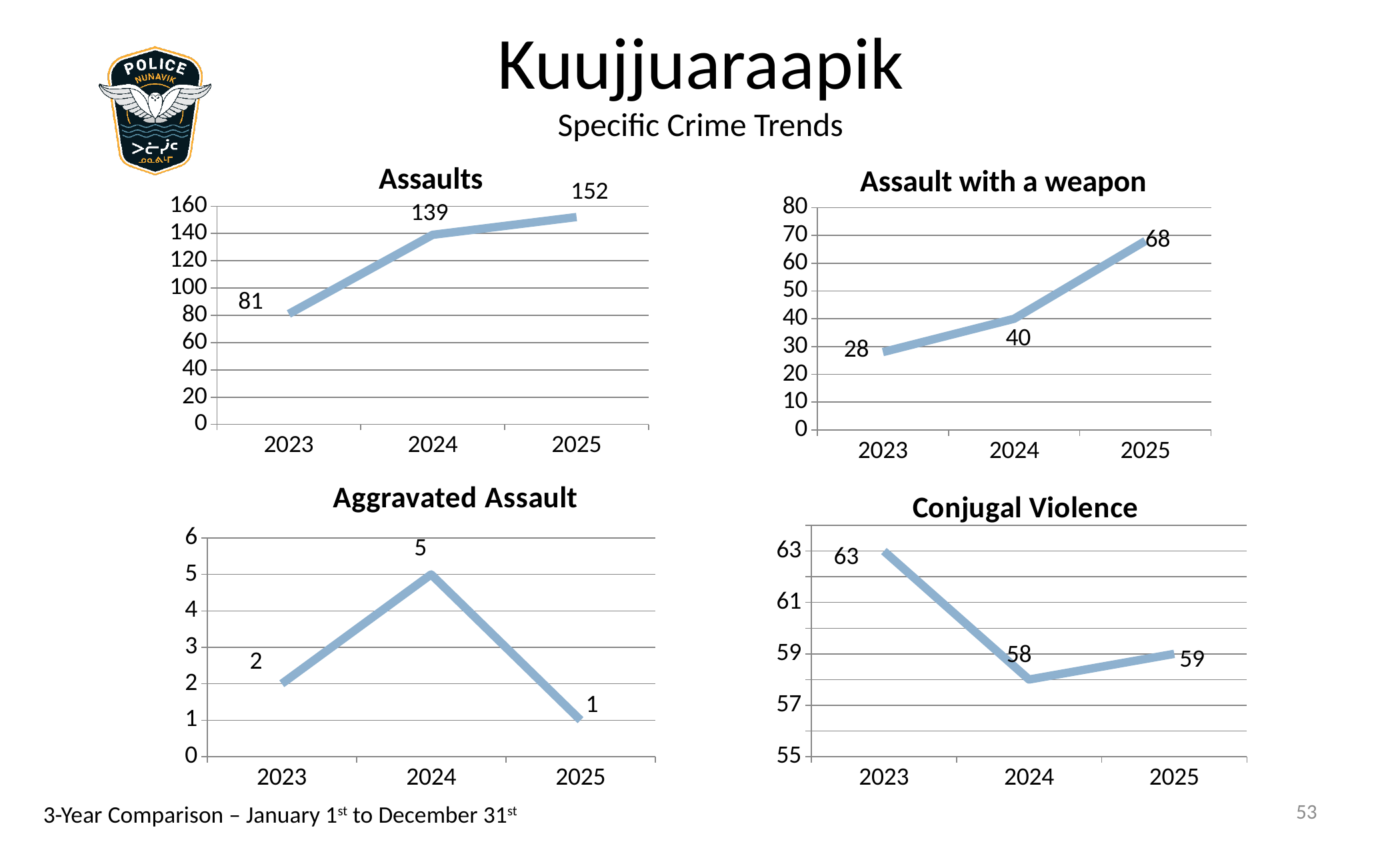
In the Assault with a weapon chart, what is the difference between the 2025 and 2024 values? 28 In the Conjugal Violence chart, which is larger, the value for 2023 or the value for 2025? 2023 How many years are plotted in the Aggravated Assault chart? 3 In the Assault with a weapon chart, what is the value for 2025? 68 In the Assaults chart, is the value for 2023 greater or less than 100? less In the Assaults chart, what is the value for 2024? 139 In the Assaults chart, what is the difference between the 2025 and 2023 values? 71 How many charts are shown on the slide? 4 In the Assault with a weapon chart, do the values rise or fall from 2023 to 2025? rise In the Conjugal Violence chart, which year has the lowest value? 2024 What kind of chart is the Assault with a weapon chart? line chart In the Aggravated Assault chart, which year has the highest value? 2024